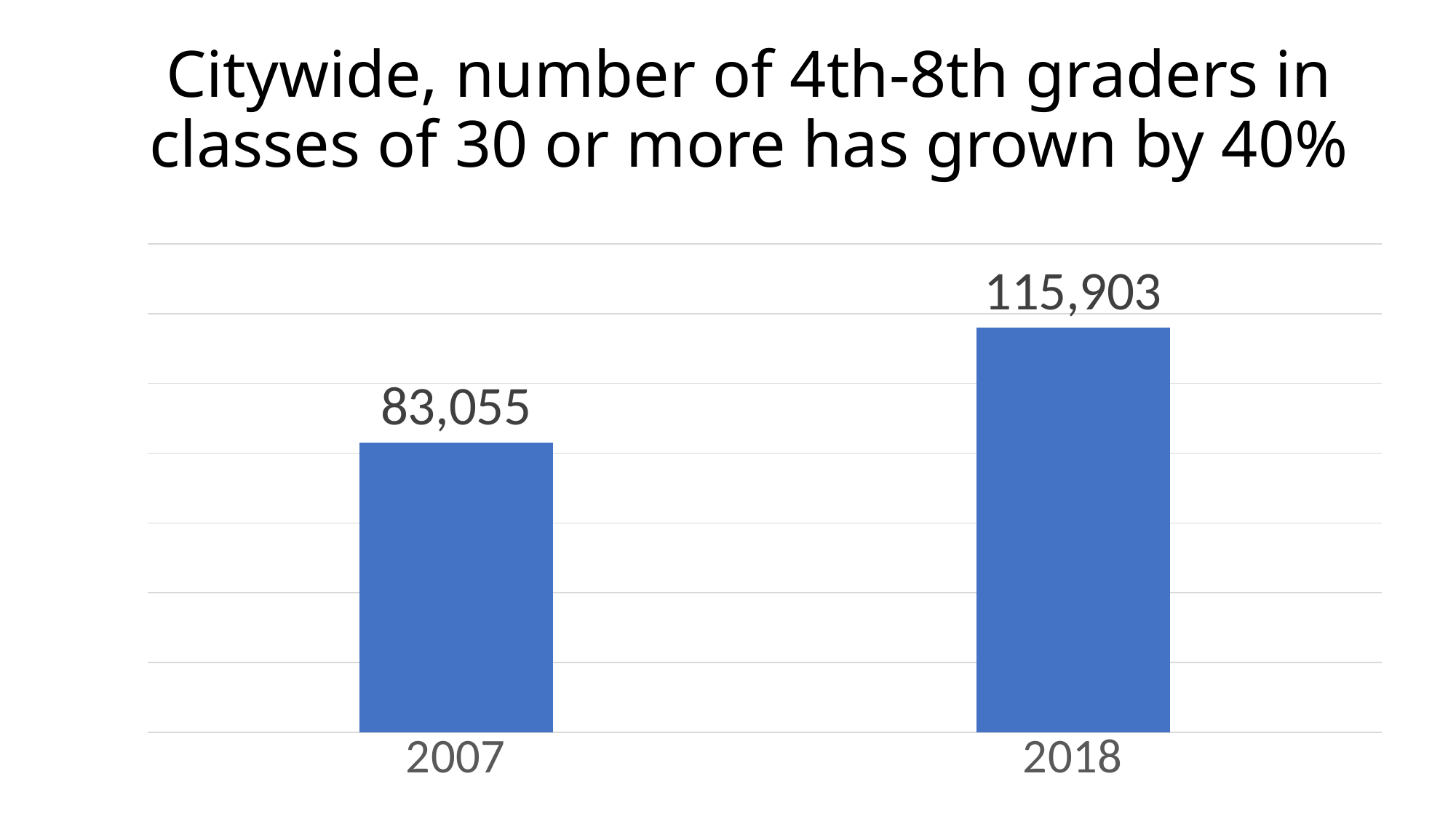
What is the title of the slide? Citywide, number of 4th-8th graders in classes of 30 or more has grown by 40% What is the value for 2018? 115,903 What is the difference between the 2018 value and the 2007 value? 32,848 Is the value for 2018 larger than the value for 2007? Yes What is the value for 2007? 83,055 Do the values rise or fall from 2007 to 2018? Rise Which year has the higher value? 2018 How many categories are shown on the x axis? 2 What colour are the bars in the chart? Blue What kind of chart is shown on the slide? Bar chart Which year has the lower value? 2007